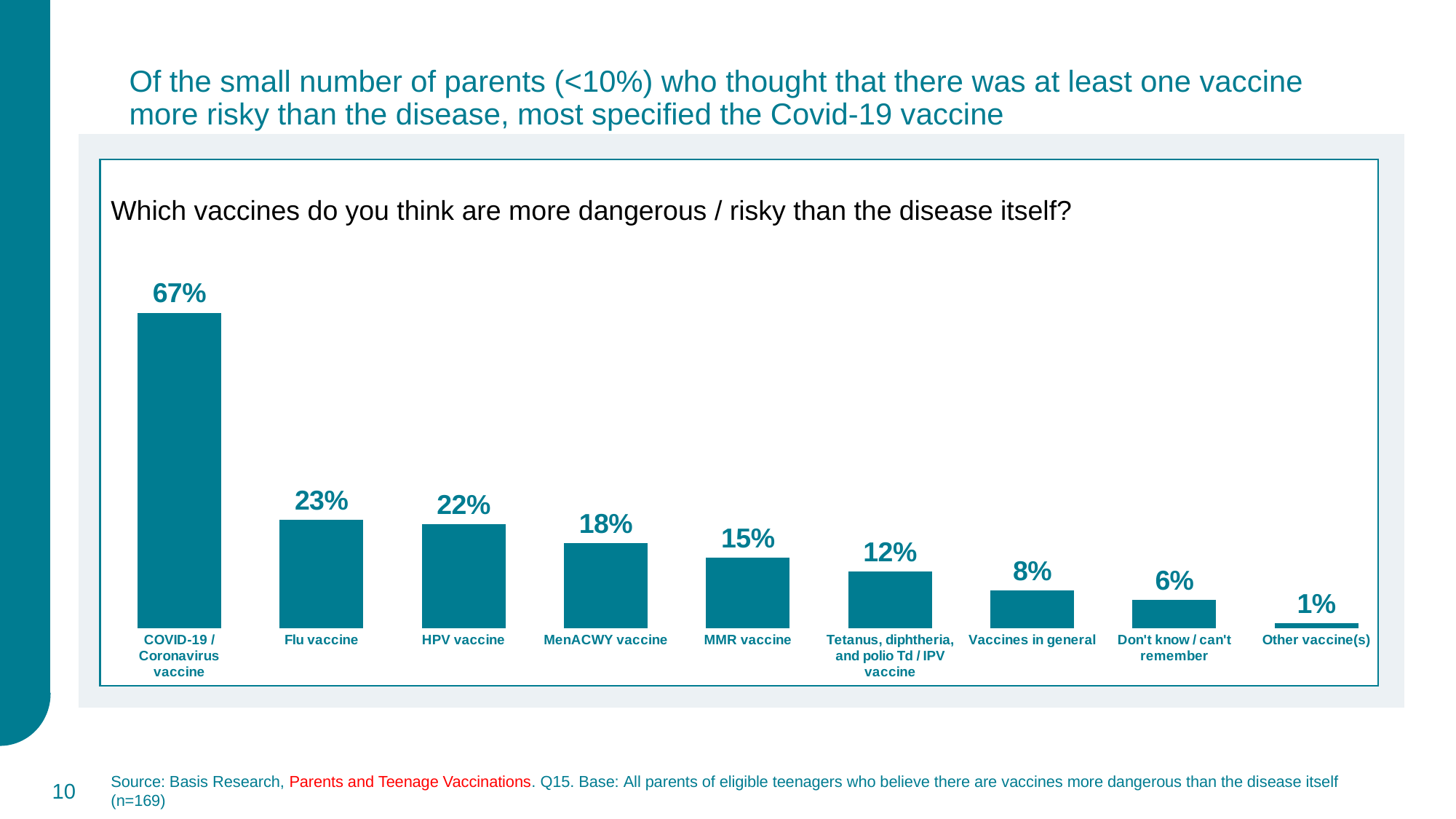
How many categories are shown in the chart? 9 What is the difference between the values for the MMR vaccine and the Tetanus, diphtheria, and polio Td / IPV vaccine? 3% Which category has the highest value in the chart? COVID-19 / Coronavirus vaccine Which has a larger value, the HPV vaccine or the MMR vaccine? HPV vaccine What is the value shown for 'Don't know / can't remember'? 6% Which category has the lowest value in the chart? Other vaccine(s) What is the question shown as the chart's title? Which vaccines do you think are more dangerous / risky than the disease itself? What kind of chart is shown on the slide? Bar chart What is the value shown for the MenACWY vaccine? 18% What is the difference between the values for the COVID-19 / Coronavirus vaccine and the Flu vaccine? 44% What percentage of parents named the COVID-19 / Coronavirus vaccine as more dangerous than the disease? 67% What is the value shown for the Flu vaccine? 23%